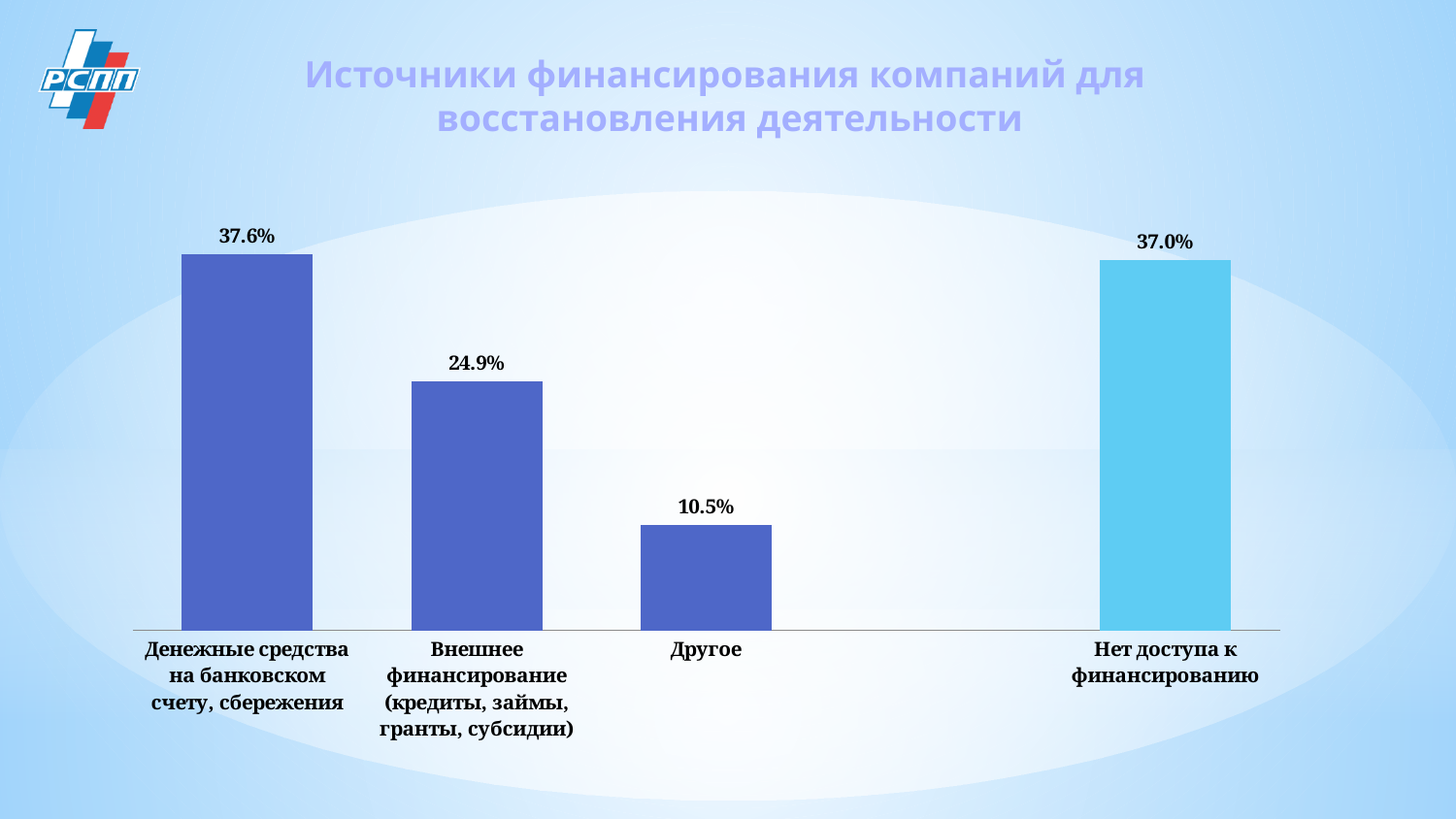
What is the value for «Внешнее финансирование (кредиты, займы, гранты, субсидии)»? 24.9% What is the difference between the values for «Денежные средства на банковском счету, сбережения» and «Нет доступа к финансированию»? 0.6% How many categories are shown in the chart? 4 Which category has the lowest value? Другое What is the value for «Нет доступа к финансированию»? 37.0% What is the difference between the values for «Внешнее финансирование (кредиты, займы, гранты, субсидии)» and «Другое»? 14.4% Which category has the highest value? Денежные средства на банковском счету, сбережения What is the title of the chart? Источники финансирования компаний для восстановления деятельности Which is larger: the value for «Внешнее финансирование (кредиты, займы, гранты, субсидии)» or the value for «Нет доступа к финансированию»? Нет доступа к финансированию What is the value for «Денежные средства на банковском счету, сбережения»? 37.6% What kind of chart is shown on the slide? Bar chart What is the value for «Другое»? 10.5%